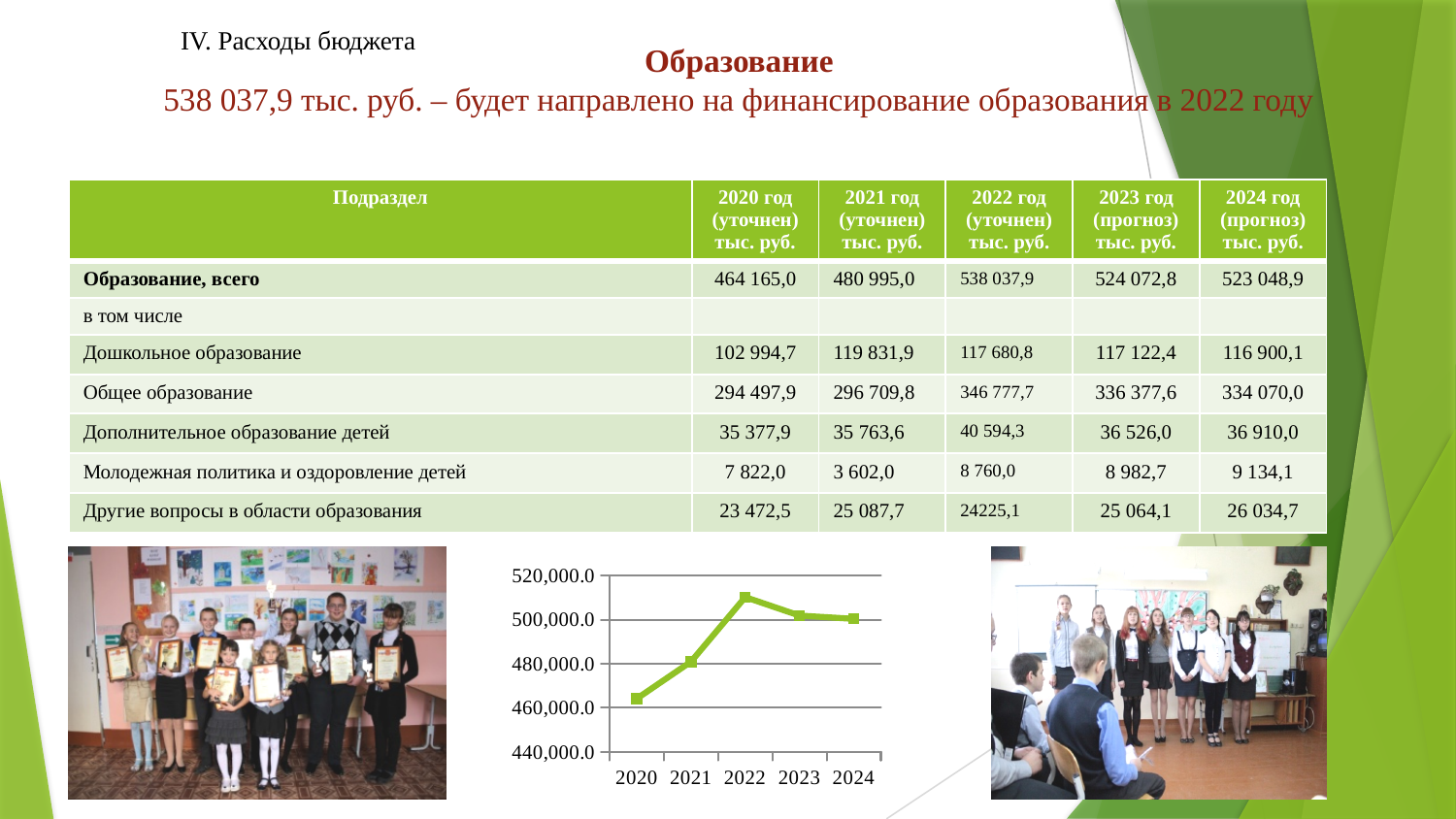
On the line chart, is the value for 2024 greater or less than 520,000.0? less On the line chart, do the values rise or fall from 2020 to 2022? rise On the line chart, is the value for 2021 greater or less than 460,000.0? greater Which year has the highest value on the line chart? 2022 On the line chart, is the value for 2020 greater or less than 480,000.0? less Which year has the lowest value on the line chart? 2020 On the line chart, which year has the larger value, 2020 or 2022? 2022 What kind of chart is shown at the bottom centre of the slide? line chart What is the highest tick value shown on the y axis of the line chart? 520,000.0 On the line chart, which year has the larger value, 2021 or 2023? 2023 How many data points are plotted on the line chart? 5